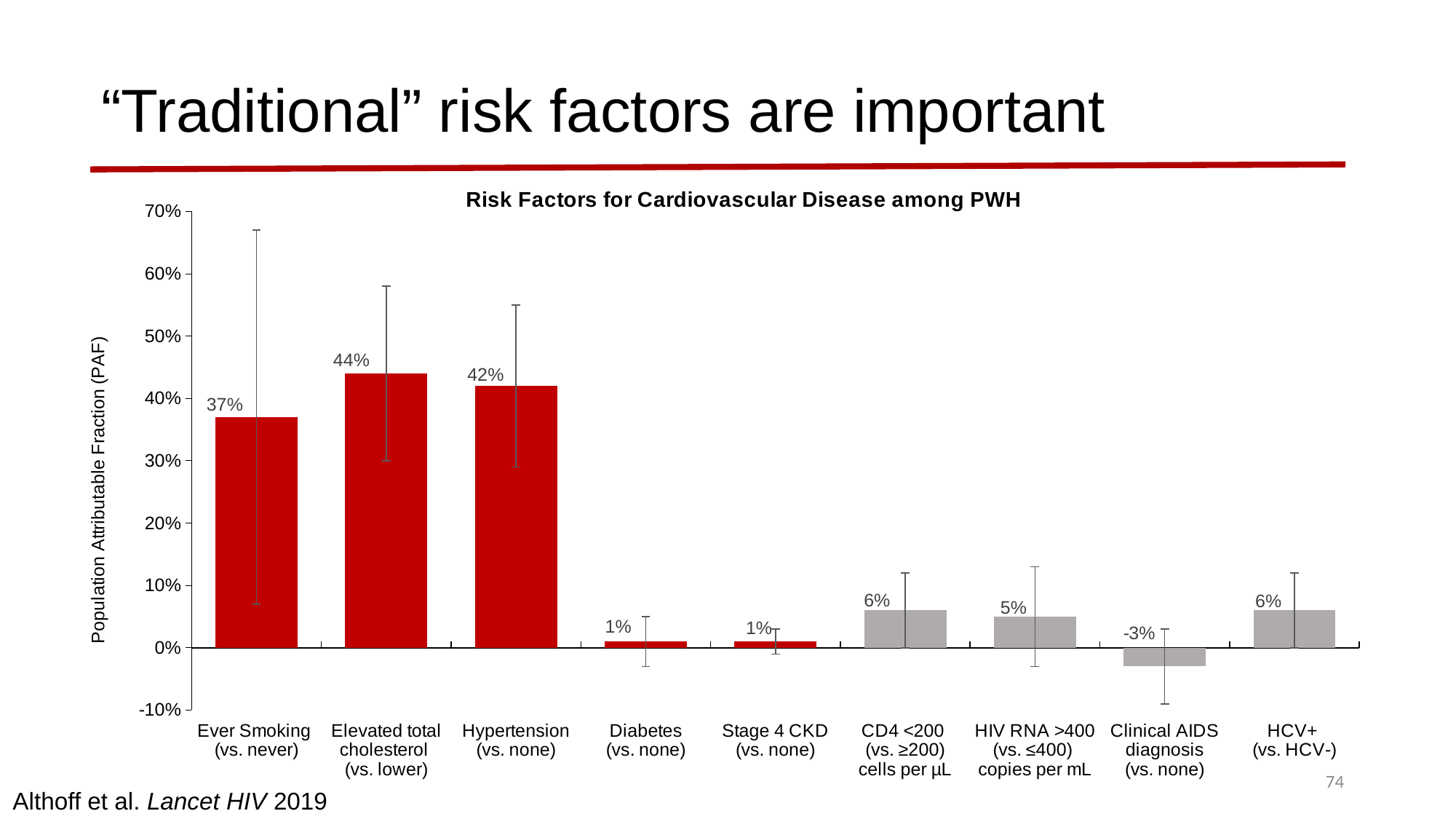
What type of chart is shown on the slide? Bar chart Which risk factor has the highest Population Attributable Fraction? Elevated total cholesterol (vs. lower) Is the PAF for Hypertension (vs. none) greater or less than 40%? greater What is the PAF value shown for Hypertension (vs. none)? 42% What is the Population Attributable Fraction for Ever Smoking (vs. never)? 37% How many risk factor categories are shown on the x axis? 9 What is the difference between the PAF for Elevated total cholesterol and the PAF for Ever Smoking? 7% What is the label of the y axis? Population Attributable Fraction (PAF) Which has a larger PAF, CD4 <200 or HIV RNA >400? CD4 <200 Which risk factor has the lowest Population Attributable Fraction? Clinical AIDS diagnosis (vs. none) What is the PAF value shown for Clinical AIDS diagnosis (vs. none)? -3% What is the title of the chart? Risk Factors for Cardiovascular Disease among PWH